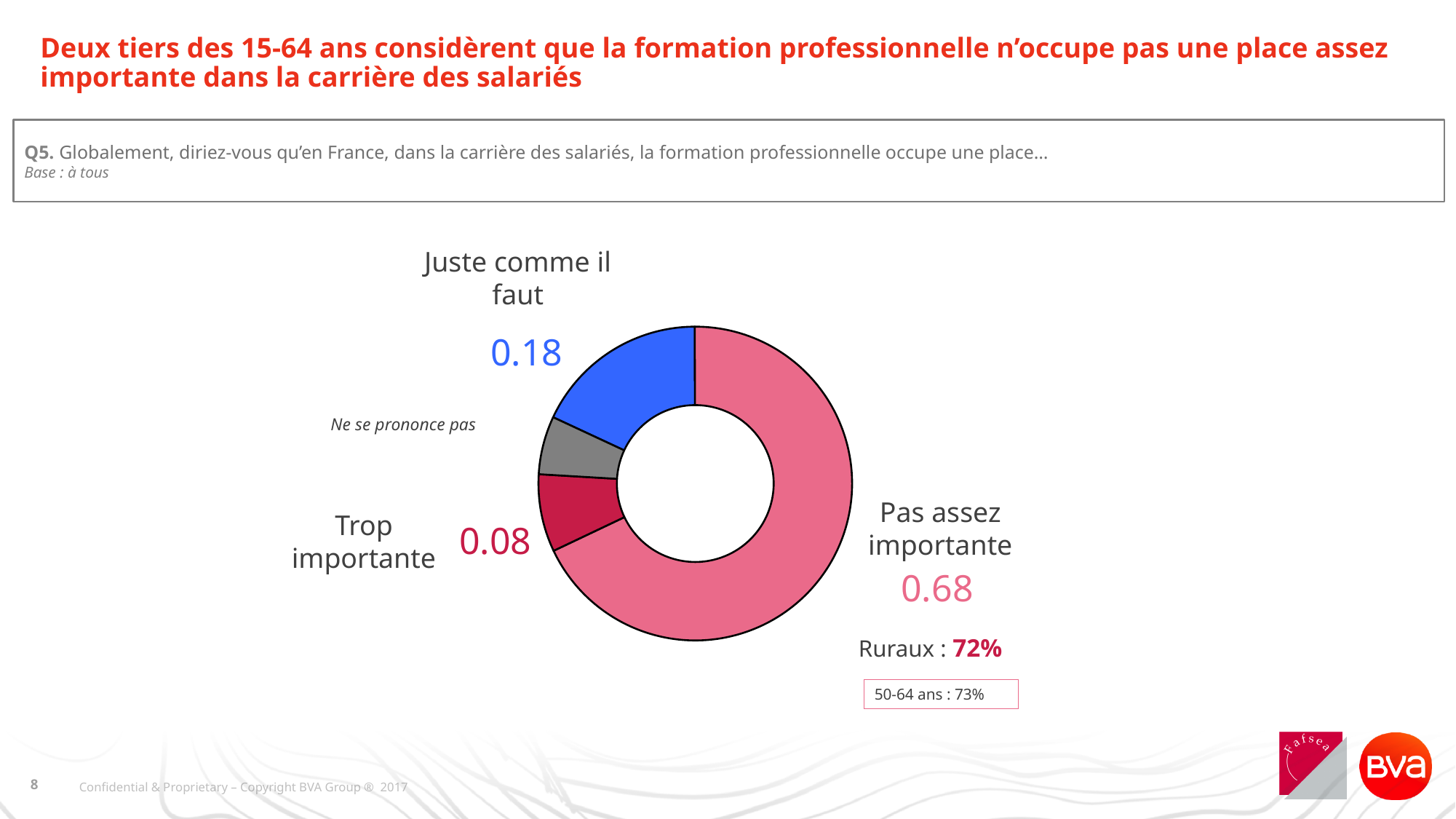
What percentage is given for "Ruraux" next to the chart? 72% How many slices does the chart have? 4 What kind of chart is shown on the slide? Pie (donut) chart What value is shown for "Juste comme il faut"? 0.18 What is the difference between the values for "Juste comme il faut" and "Trop importante"? 0.10 What value is shown for "Pas assez importante"? 0.68 Which is larger, the value for "Juste comme il faut" or the value for "Trop importante"? Juste comme il faut Which category is shown in blue on the chart? Juste comme il faut What value is shown for "Trop importante"? 0.08 What is the difference between the values for "Pas assez importante" and "Juste comme il faut"? 0.50 Which category has the largest slice of the chart? Pas assez importante